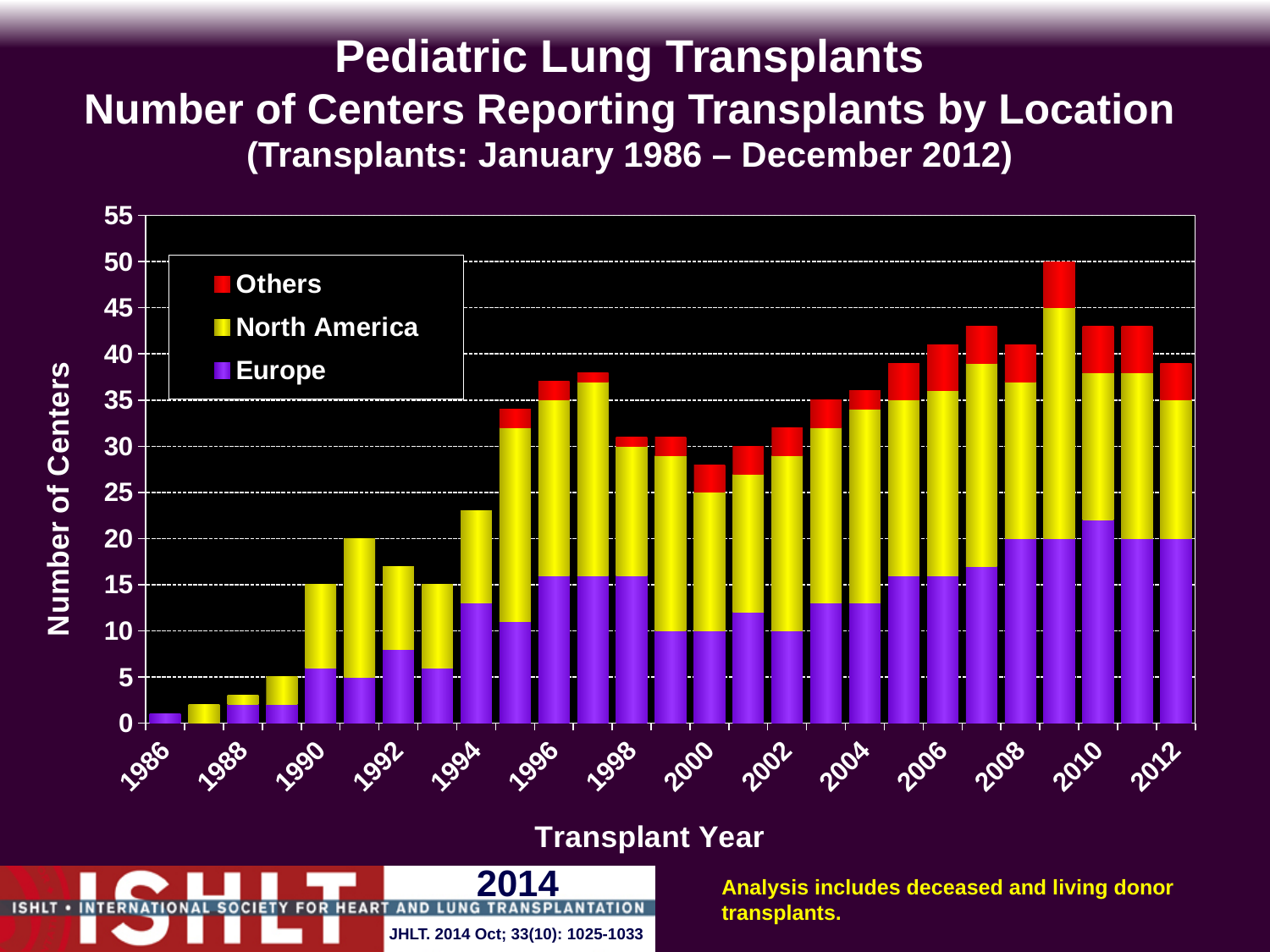
Is the total number of centers in 2000 greater or less than 25? greater What is the label on the vertical axis? Number of Centers How many series does the legend list? 3 Which year has a larger total number of centers, 1991 or 1992? 1991 Which three locations are listed in the legend? Others, North America, Europe Does the total number of centers rise or fall from 1986 to 1991? rise Which transplant year has the highest total number of centers reporting? 2009 Is the total number of centers in 2009 greater or less than 45? greater Is the total number of centers in 1986 greater or less than 5? less What kind of chart is shown on the slide? Stacked bar chart Which transplant year has the lowest total number of centers reporting? 1986